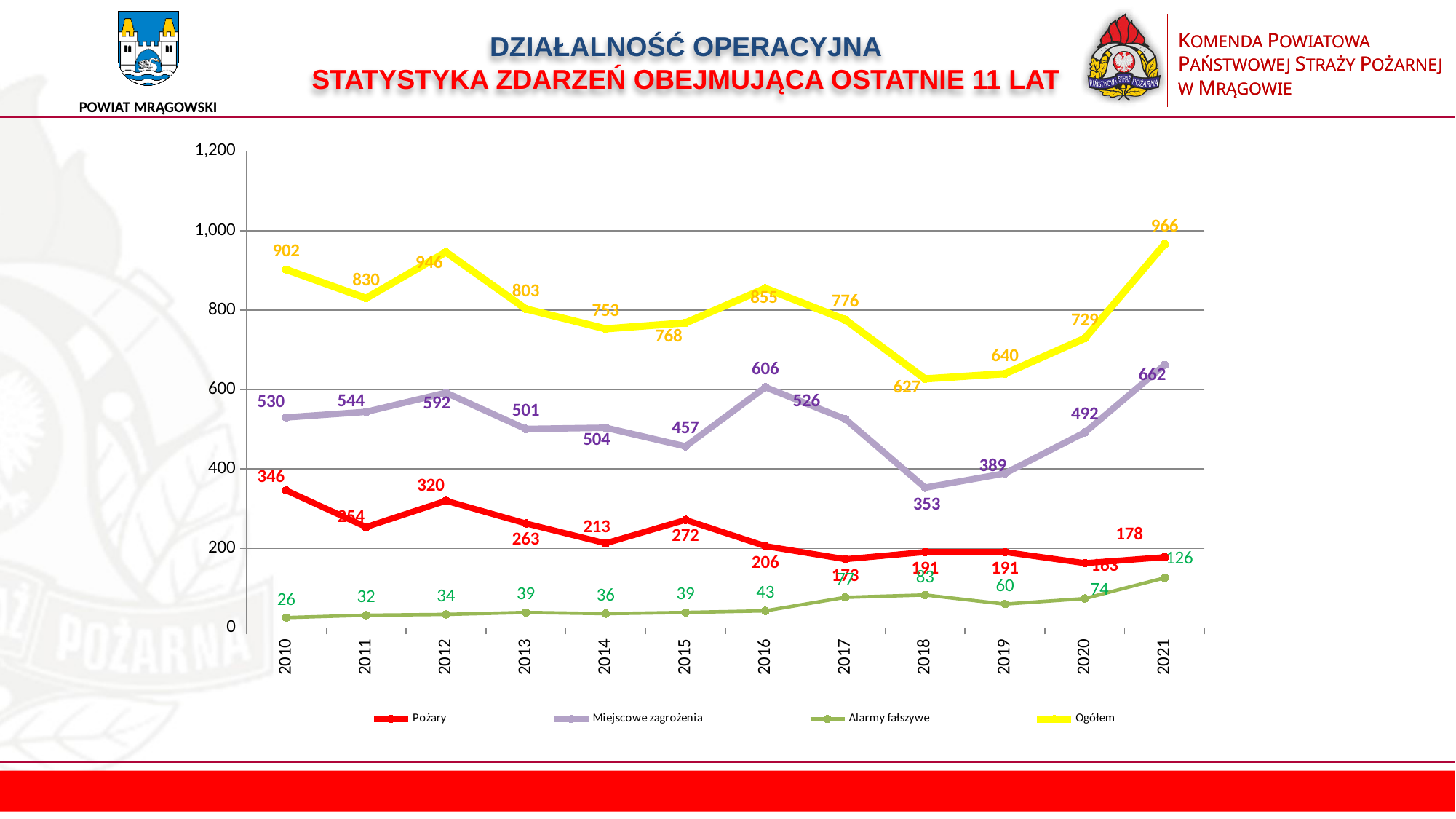
How many series does the legend list? 4 Does the Alarmy fałszywe series rise or fall from 2010 to 2016? rise What kind of chart is shown on the slide? line chart In which year is the Miejscowe zagrożenia series at its lowest? 2018 Is the value for Miejscowe zagrożenia in 2021 greater or less than 600? greater In which year does the Ogółem series reach its highest value? 2021 Which year has the higher Pożary value, 2010 or 2012? 2010 In which year does the Ogółem series reach its lowest value? 2018 What is the value of the Ogółem series in 2012? 946 What is the value of Miejscowe zagrożenia in 2016? 606 How many years are shown on the x axis? 12 What is the difference between the Ogółem values for 2021 and 2010? 64